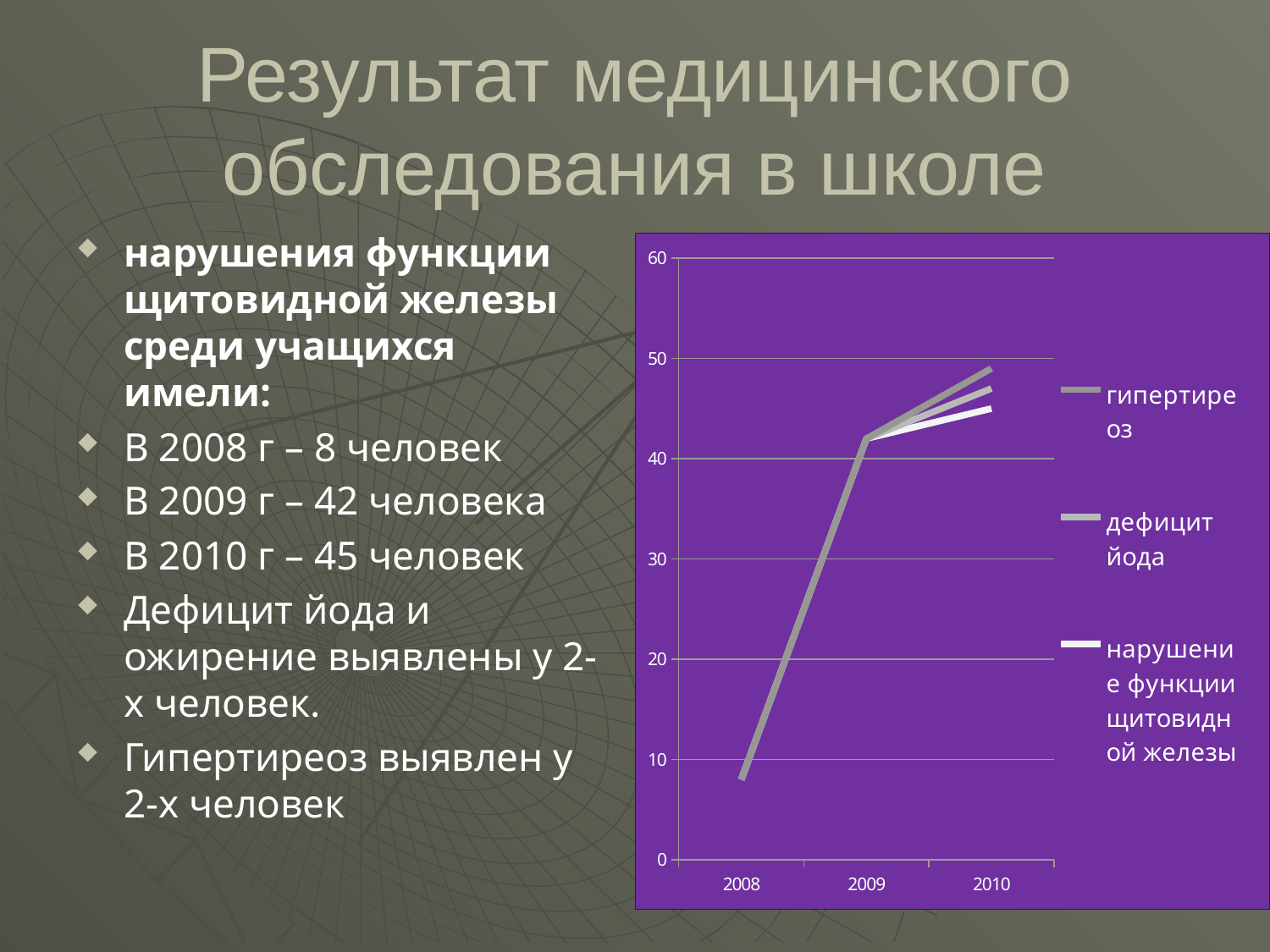
Do the plotted values rise or fall from 2008 to 2010? rise Which series has the highest value in 2010? гипертиреоз Which series has the lowest value in 2010? нарушения функции щитовидной железы What is the first year label on the x axis of the chart? 2008 Is the 2009 value for дефицит йода greater or less than 40? greater What kind of chart is shown on the slide? line chart What is the highest tick value shown on the y axis of the chart? 60 How many series does the chart legend list? 3 Is the 2008 value for нарушения функции щитовидной железы greater or less than 10? less In 2010, which is higher: гипертиреоз or нарушения функции щитовидной железы? гипертиреоз How many years are shown on the x axis of the chart? 3 Is the 2010 value for гипертиреоз greater or less than 40? greater